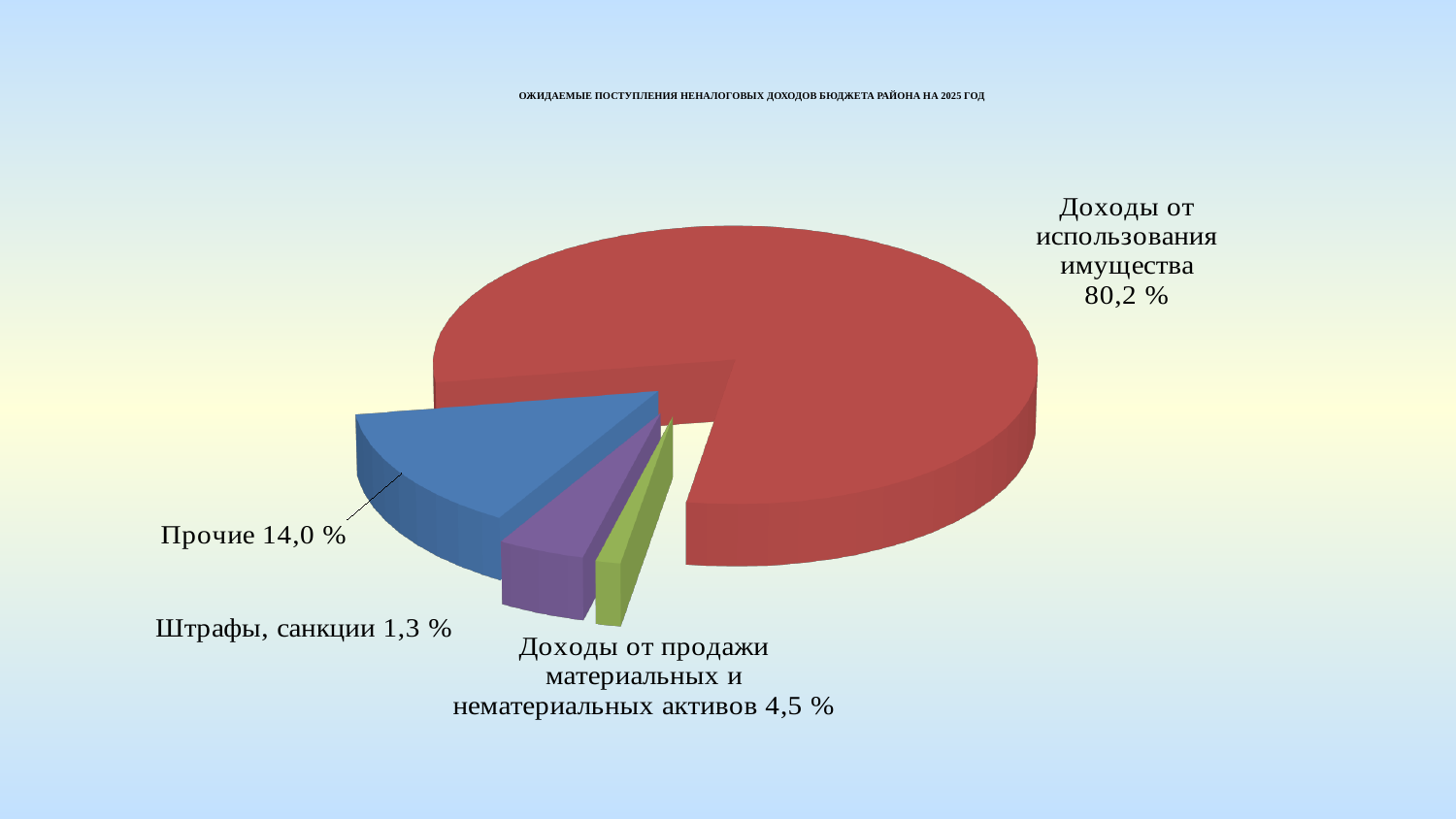
What kind of chart is shown on the slide? Pie chart What is the title of the chart? ОЖИДАЕМЫЕ ПОСТУПЛЕНИЯ НЕНАЛОГОВЫХ ДОХОДОВ БЮДЖЕТА РАЙОНА НА 2025 ГОД Which is larger: Прочие or Доходы от продажи материальных и нематериальных активов? Прочие What is the difference in percentage points between Доходы от использования имущества and Прочие? 66,2 What is the value shown for Штрафы, санкции? 1,3 % How many slices does the pie chart have? 4 What share of the pie does Доходы от использования имущества represent? 80,2 % What colour is the slice for Доходы от использования имущества? Red What is the value shown for Доходы от продажи материальных и нематериальных активов? 4,5 % Which category has the largest share of the pie? Доходы от использования имущества Which category has the smallest share of the pie? Штрафы, санкции What is the value shown for Прочие? 14,0 %